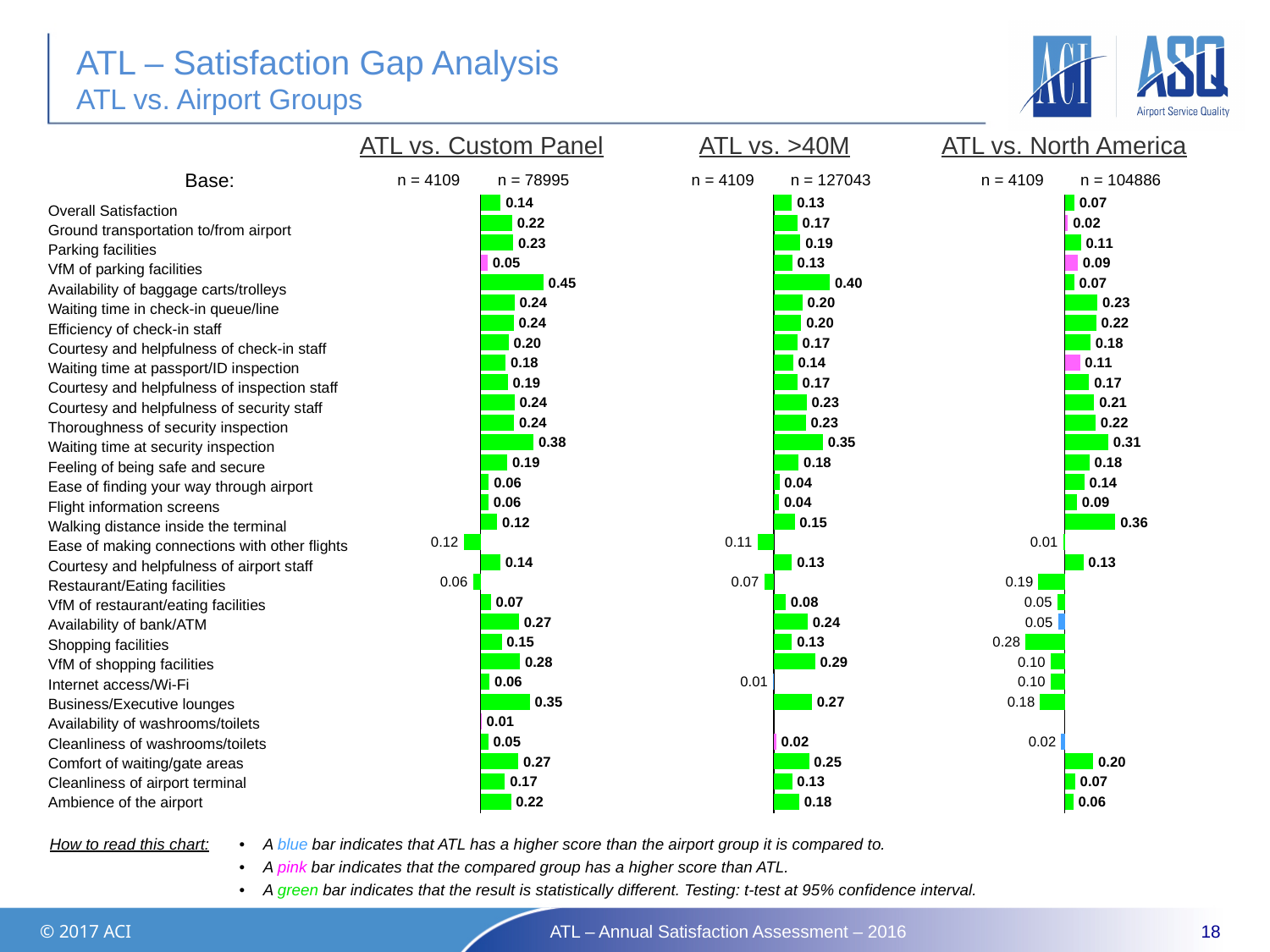
In the ATL vs. Custom Panel chart, what is the value for Overall Satisfaction? 0.14 In the ATL vs. Custom Panel chart, which category has the highest value? Availability of baggage carts/trolleys In the ATL vs. North America chart, what is the value for Comfort of waiting/gate areas? 0.20 In the ATL vs. >40M chart, which is larger: the value for Availability of bank/ATM or the value for VfM of shopping facilities? VfM of shopping facilities According to the slide, what colour bar indicates that the compared group has a higher score than ATL? Pink What kind of chart is used in the ATL vs. Custom Panel comparison? Bar chart In the ATL vs. >40M chart, what is the value for Overall Satisfaction? 0.13 In the ATL vs. Custom Panel chart, what is the value for Business/Executive lounges? 0.35 In the ATL vs. Custom Panel chart, what is the difference between the values for Availability of baggage carts/trolleys and Waiting time at security inspection? 0.07 In the ATL vs. >40M chart, what is the value for Waiting time at security inspection? 0.35 What is the base (n) shown for the Custom Panel group in the ATL vs. Custom Panel chart? n = 78995 In the ATL vs. North America chart, what is the value for Walking distance inside the terminal? 0.36